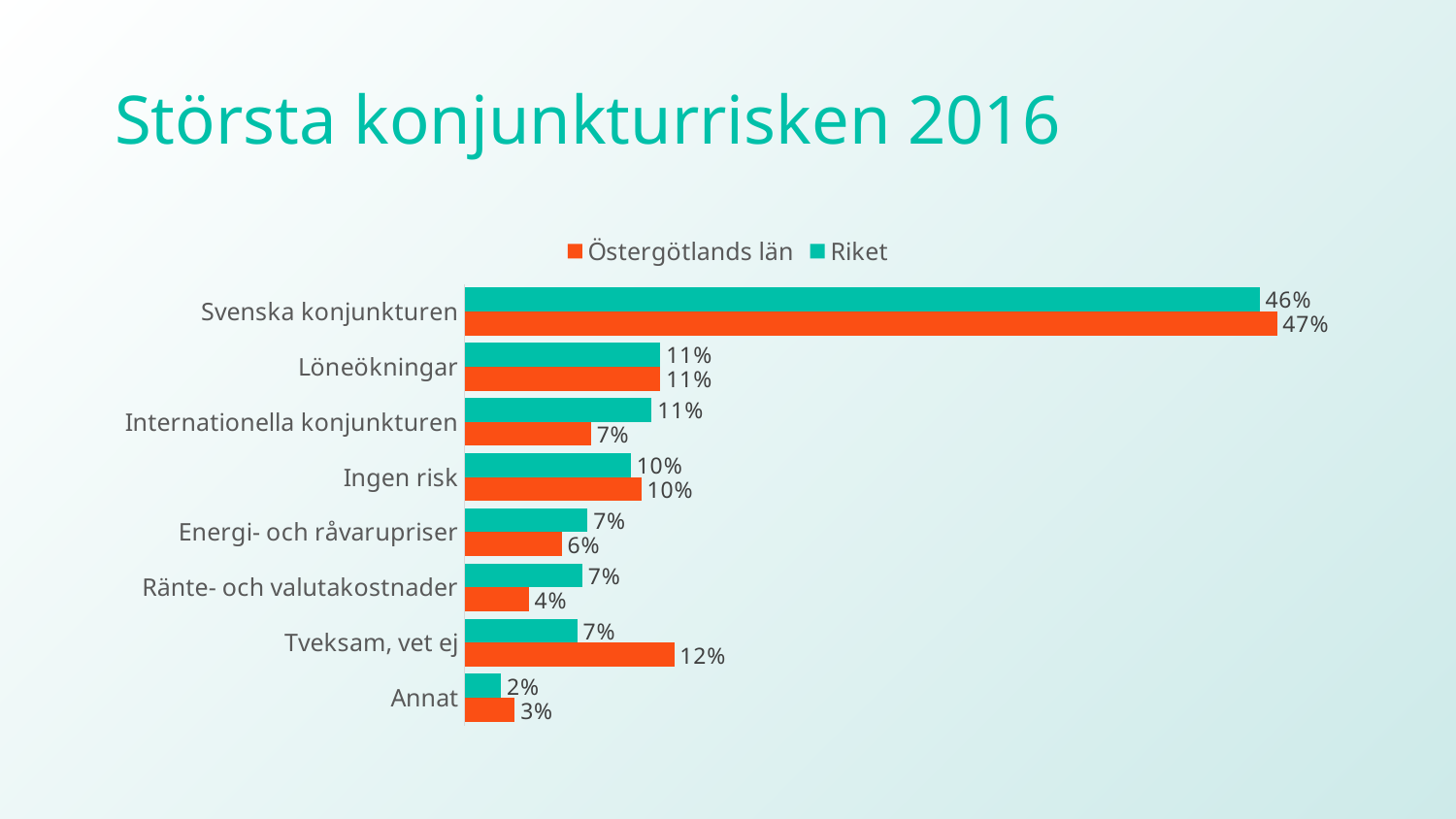
What is the difference between Östergötlands län and Riket for Tveksam, vet ej? 5% Which is larger for Ränte- och valutakostnader, Östergötlands län or Riket? Riket How many categories are shown on the chart? 8 Which is larger for Tveksam, vet ej, Östergötlands län or Riket? Östergötlands län How many series does the legend list? 2 What is the value for Östergötlands län for Svenska konjunkturen? 47% What kind of chart is shown on the slide? Bar chart What is the difference between Riket and Östergötlands län for Internationella konjunkturen? 4% Which category has the highest value for Riket? Svenska konjunkturen What is the value for Riket for Tveksam, vet ej? 7% What is the value for Östergötlands län for Ränte- och valutakostnader? 4% Which category has the lowest value for Östergötlands län? Annat